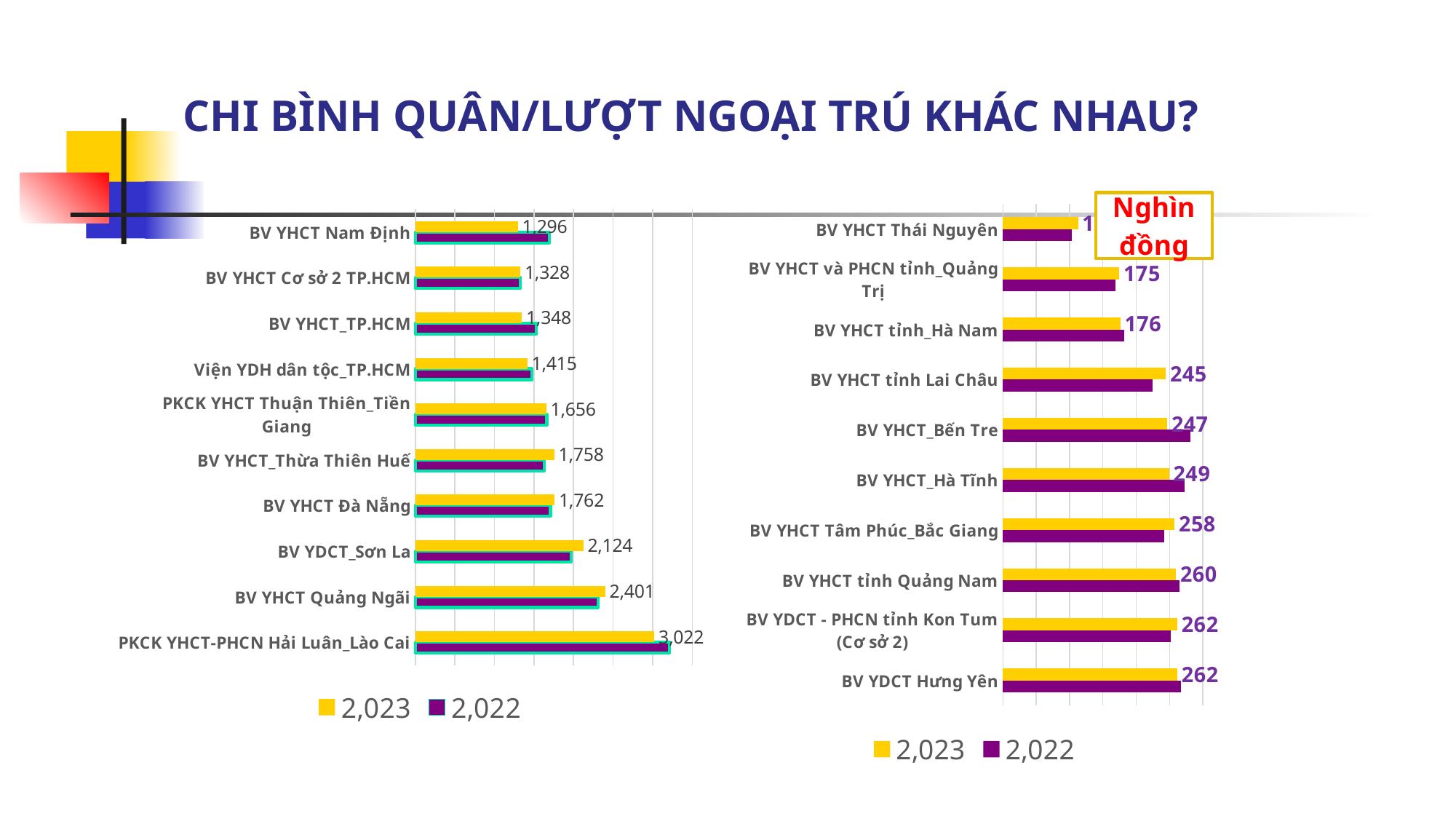
On the left chart, which category has the highest 2,023 value? PKCK YHCT-PHCN Hải Luân_Lào Cai How many series does the legend of the left chart list? 2 On the left chart, which has the larger 2,023 value: BV YDCT_Sơn La or BV YHCT_Thừa Thiên Huế? BV YDCT_Sơn La On the left chart, what is the difference between the 2,023 values for BV YHCT Quảng Ngãi and BV YDCT_Sơn La? 277 How many categories are shown on the right chart? 10 On the right chart, which category has the shortest 2,023 bar? BV YHCT Thái Nguyên On the left chart, what is the 2,023 value for BV YHCT Đà Nẵng? 1,762 On the left chart, what is the 2,023 value for PKCK YHCT-PHCN Hải Luân_Lào Cai? 3,022 On the left chart, which category has the lowest 2,023 value? BV YHCT Nam Định On the right chart, what is the 2,023 value for BV YHCT và PHCN tỉnh_Quảng Trị? 175 On the right chart, what is the difference between the 2,023 values for BV YHCT tỉnh Lai Châu and BV YHCT tỉnh_Hà Nam? 69 On the right chart, what is the 2,023 value for BV YHCT tỉnh Lai Châu? 245